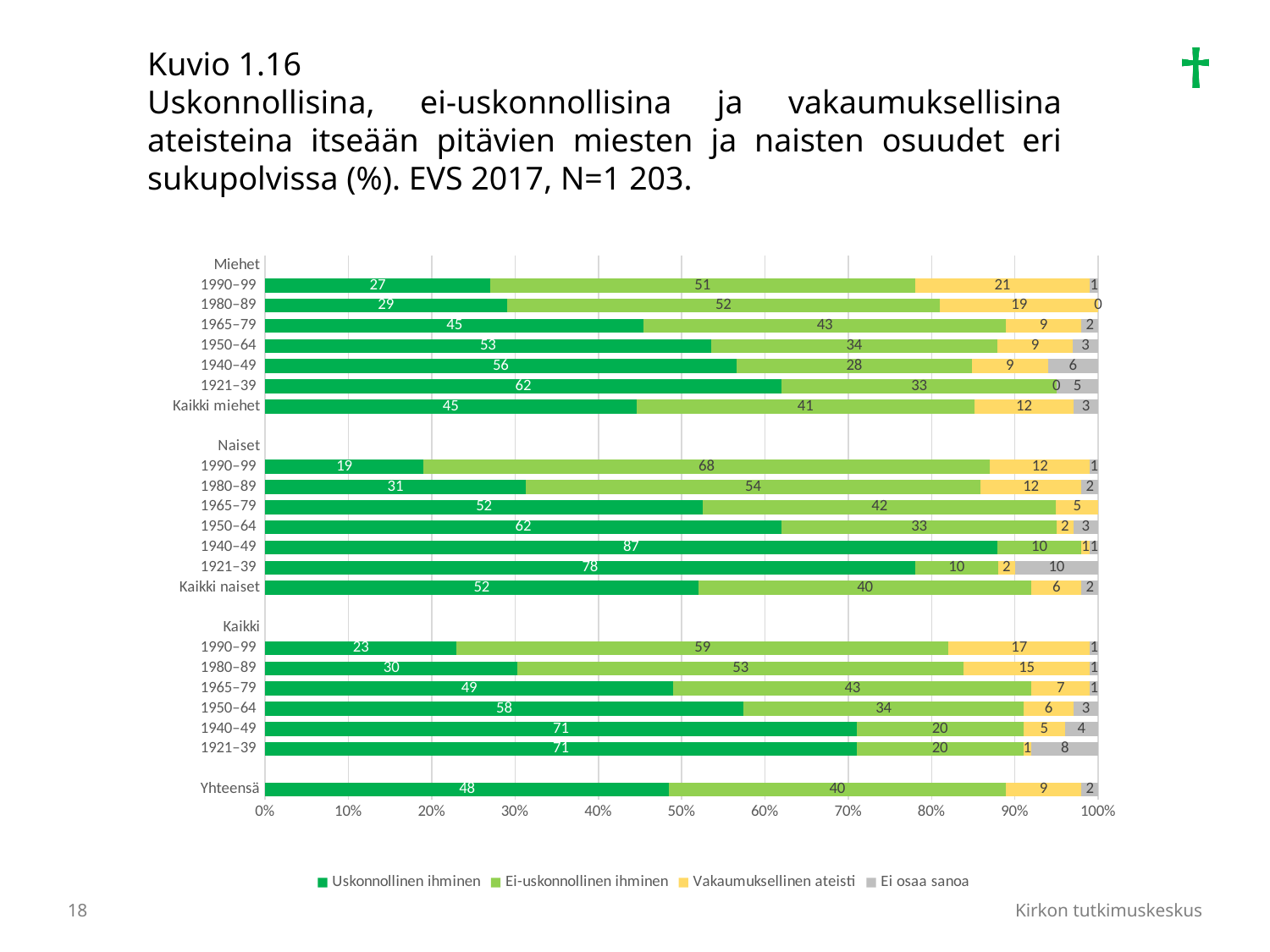
What is the value of 'Vakaumuksellinen ateisti' for Miehet 1990–99? 21 Which legend entry is shown in grey? Ei osaa sanoa What is the value of 'Uskonnollinen ihminen' for the Yhteensä bar? 48 What is the difference between the 'Uskonnollinen ihminen' values for Kaikki naiset and Kaikki miehet? 7 What type of chart is shown on the slide? stacked bar chart How many series does the legend list? 4 What is the value of 'Ei-uskonnollinen ihminen' for Naiset 1990–99? 68 Which is larger: the 'Uskonnollinen ihminen' value for Miehet 1921–39 or for Naiset 1921–39? Naiset 1921–39 What is the value of 'Vakaumuksellinen ateisti' for Kaikki 1980–89? 15 Among the Miehet generation bars, which generation has the lowest 'Uskonnollinen ihminen' value? 1990–99 What is the value of 'Ei osaa sanoa' for Naiset 1921–39? 10 Among the Naiset generation bars, which generation has the highest 'Uskonnollinen ihminen' value? 1940–49